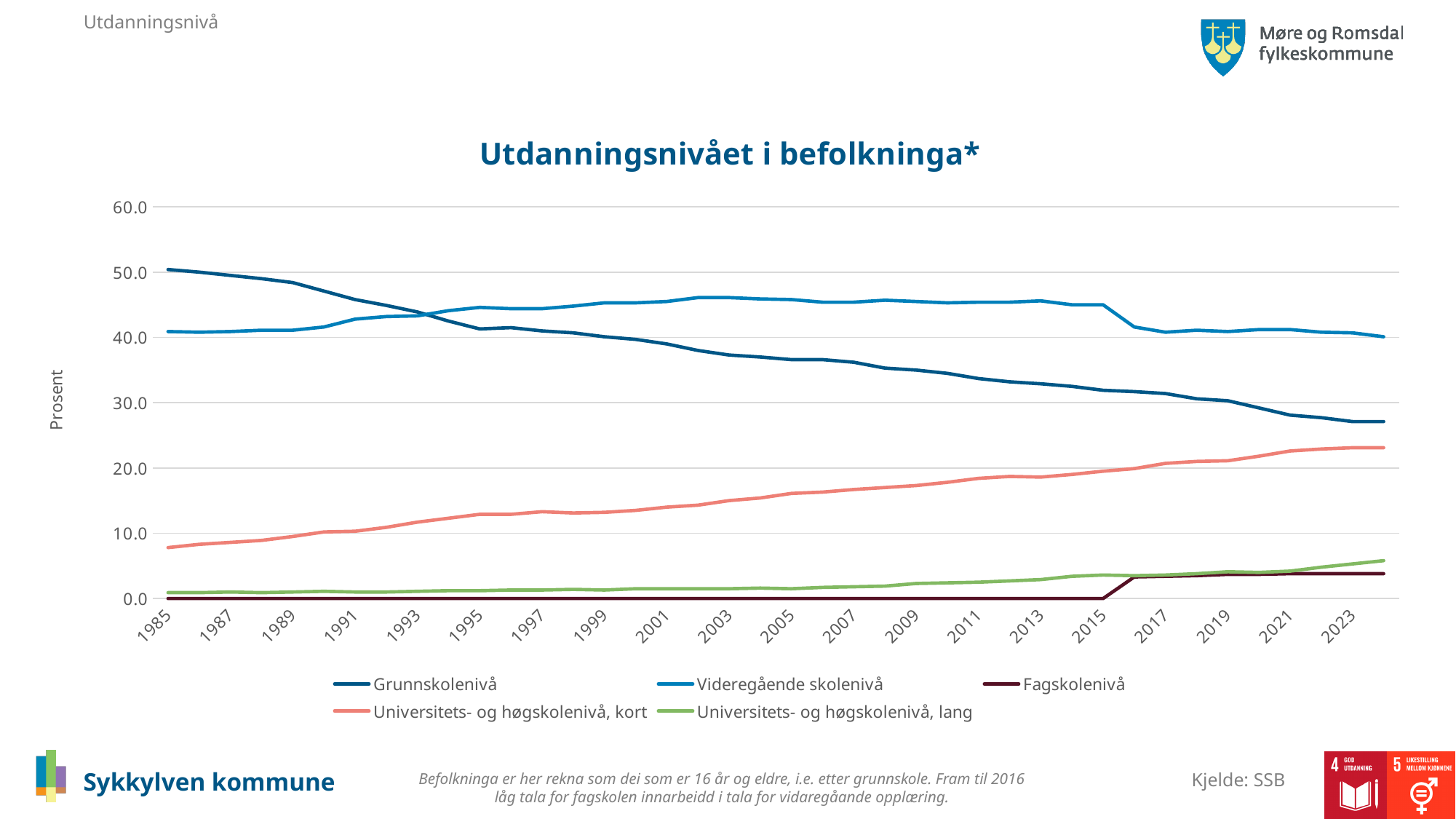
Does the value for Grunnskolenivå rise or fall from 1985 to 2023? Fall Is the value for Grunnskolenivå in 2023 greater or less than 30.0? less In 2023, which is larger: Videregående skolenivå or Grunnskolenivå? Videregående skolenivå Is the value for Grunnskolenivå in 1985 greater or less than 40.0? greater Does the value for Universitets- og høgskolenivå, kort rise or fall from 1985 to 2023? Rise Is the value for Universitets- og høgskolenivå, kort in 2023 greater or less than 20.0? greater What is the label on the vertical axis? Prosent What is the title of the chart? Utdanningsnivået i befolkninga* Which series has the highest value in 1985? Grunnskolenivå What kind of chart is shown on the slide? Line chart How many series does the legend list? 5